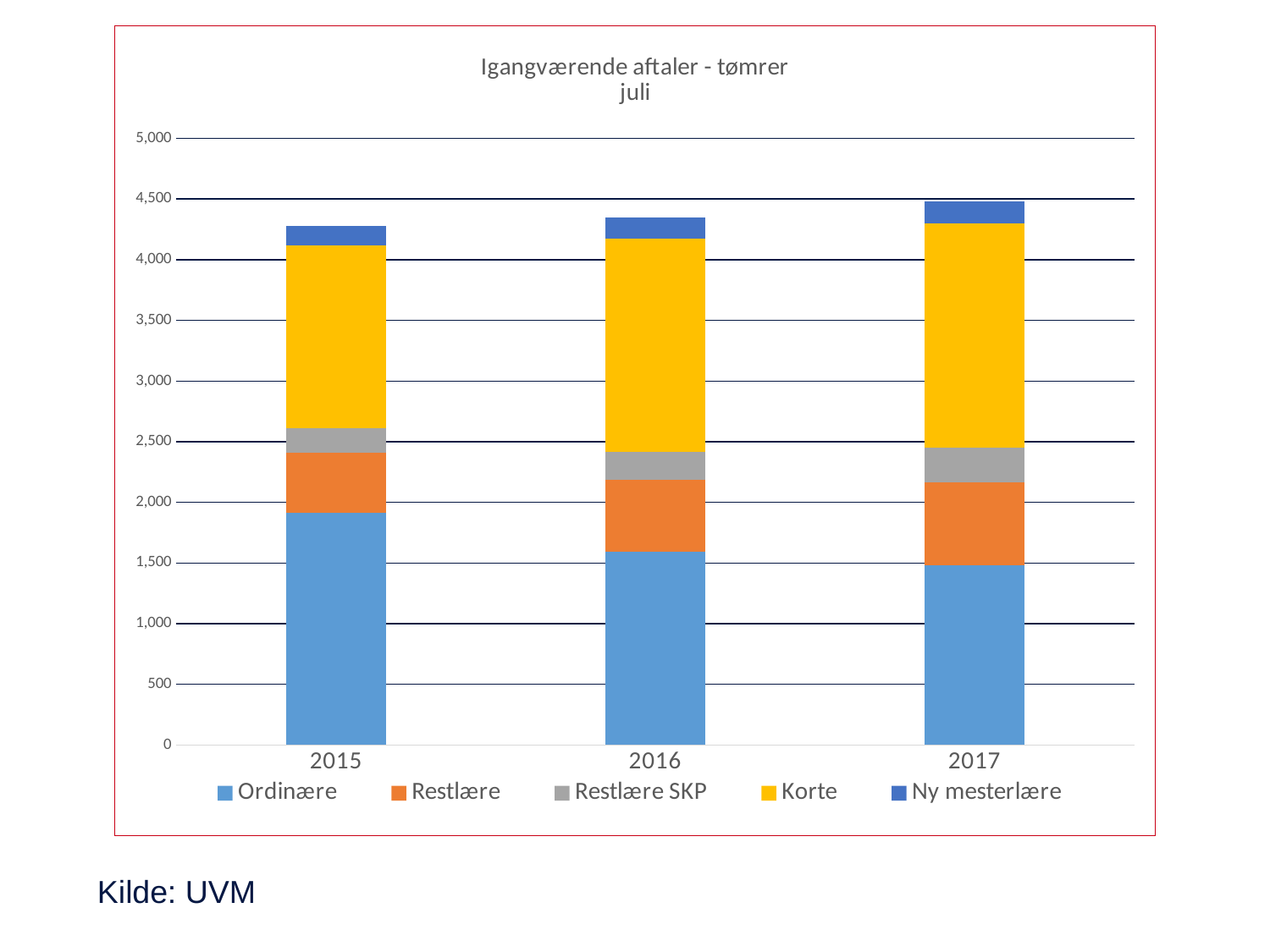
How many series does the chart's legend list? 5 Is the Ordinære segment larger in 2015 or in 2017? 2015 What is the title of the chart? Igangværende aftaler - tømrer juli Which year has the tallest total stacked bar? 2017 Which series is shown in yellow in the chart? Korte Which year has the shortest total stacked bar? 2015 Is the Ordinære value for 2015 greater or less than 1,500? greater What kind of chart is shown on the slide? Stacked bar chart Is the Ordinære value for 2017 greater or less than 2,000? less Does the Ordinære segment rise or fall from 2015 to 2017? fall How many years are shown on the x axis of the chart? 3 Is the total stacked bar for 2015 greater or less than 4,000? greater